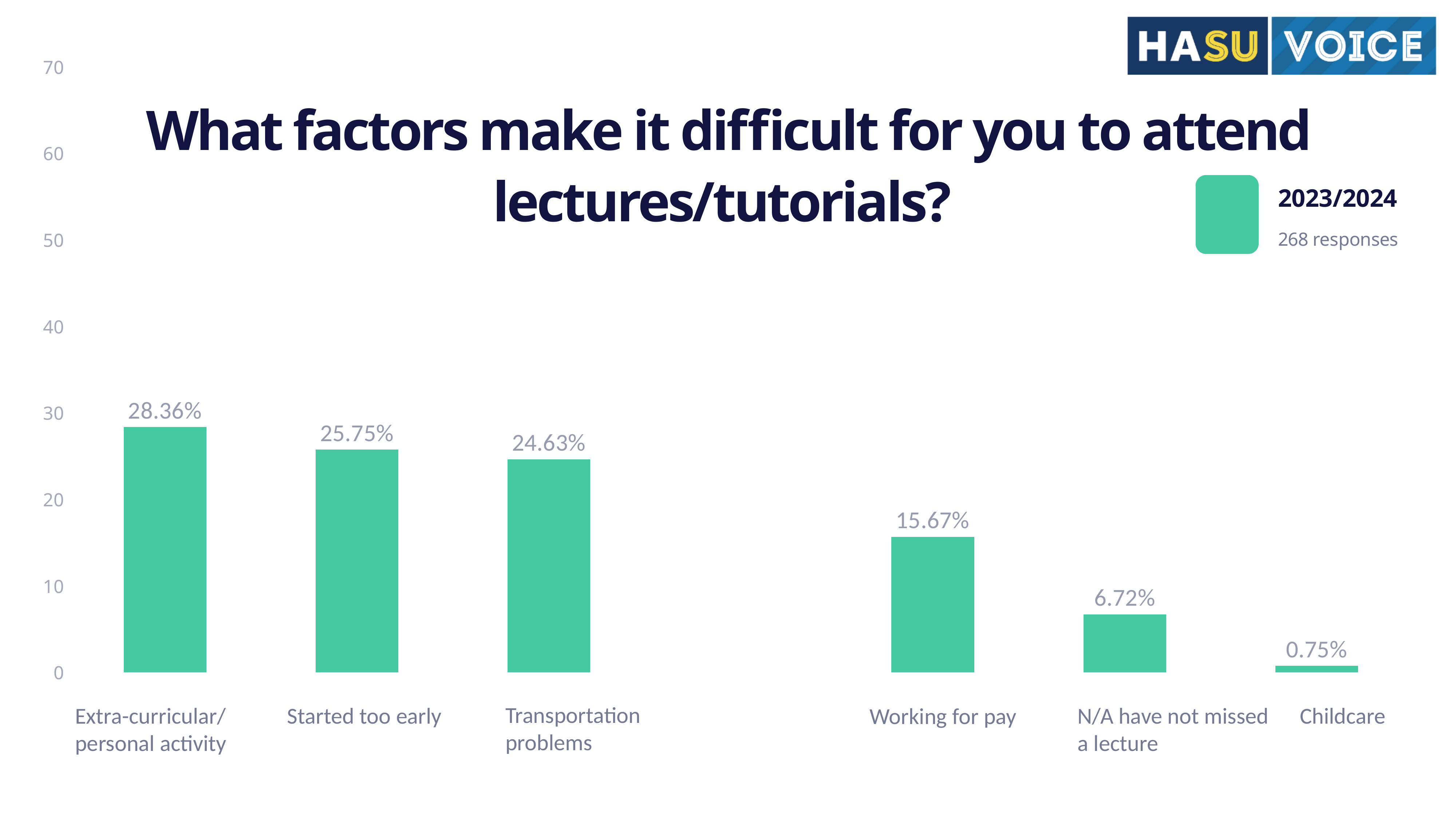
What is the value for Extra-curricular/personal activity? 28.36% What is the value for N/A have not missed a lecture? 6.72% What kind of chart is shown on the slide? Bar chart Which category has the lowest value? Childcare Which category has the highest value? Extra-curricular/personal activity What is the difference between the values for Started too early and Transportation problems? 1.12% Which is larger, the value for Working for pay or the value for N/A have not missed a lecture? Working for pay Is the value for Transportation problems greater or less than 20? greater What is the value for Childcare? 0.75% What is the value for Working for pay? 15.67% What is the difference between the values for Extra-curricular/personal activity and Working for pay? 12.69% How many responses does the legend say the 2023/2024 series is based on? 268 responses